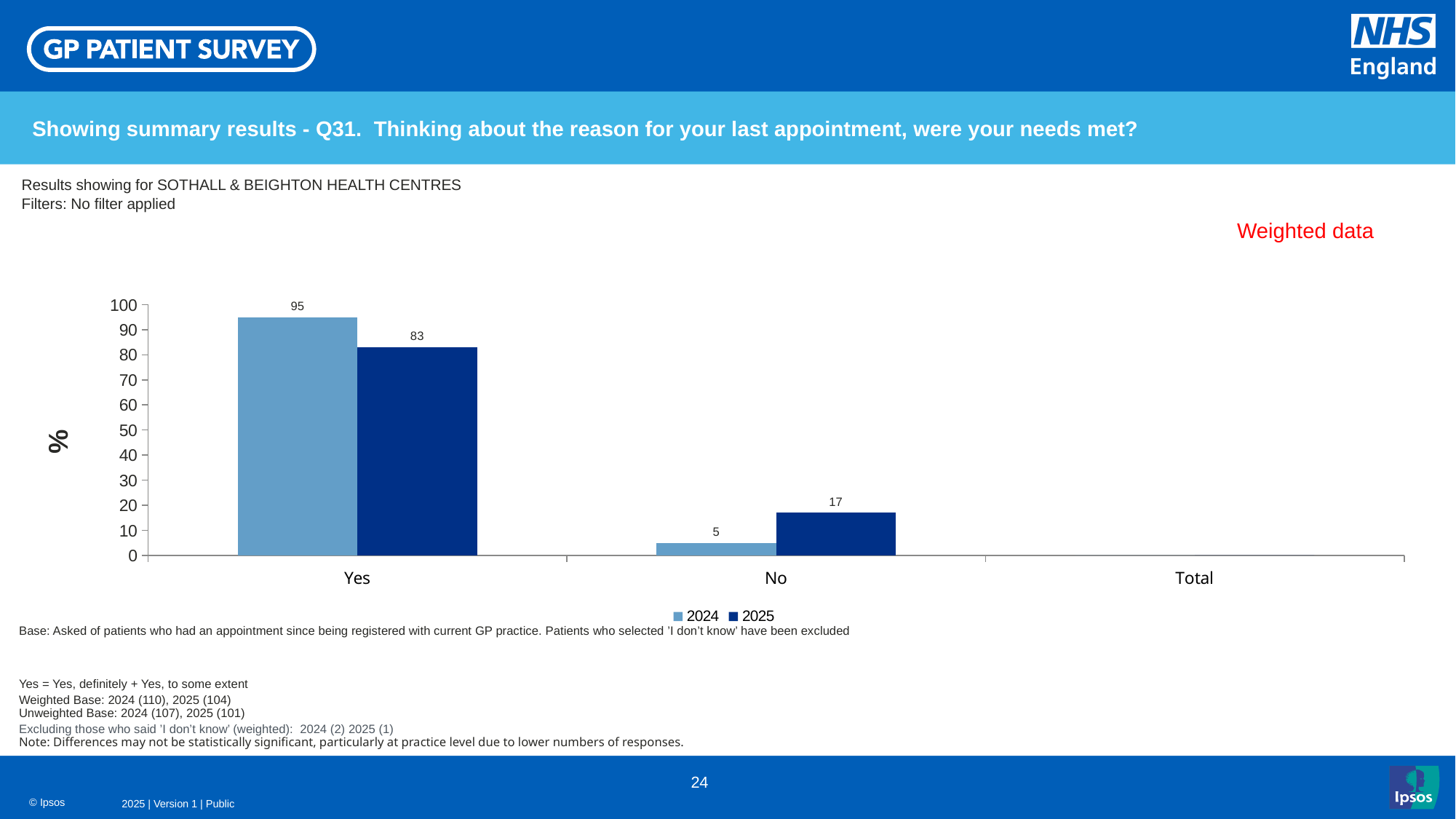
What is the value for No in 2025? 17 What is the value for No in 2024? 5 What label is shown on the vertical axis? % What is the value for Yes in 2025? 83 What is the difference between the 2025 and 2024 values for No? 12 What kind of chart is shown on the slide? Bar chart What is the value for Yes in 2024? 95 Which category has the lowest value for 2024? No Which is larger, the 2024 value for Yes or the 2025 value for Yes? 2024 What is the difference between the 2024 and 2025 values for Yes? 12 How many series does the legend list? 2 Which category has the highest value for 2025? Yes